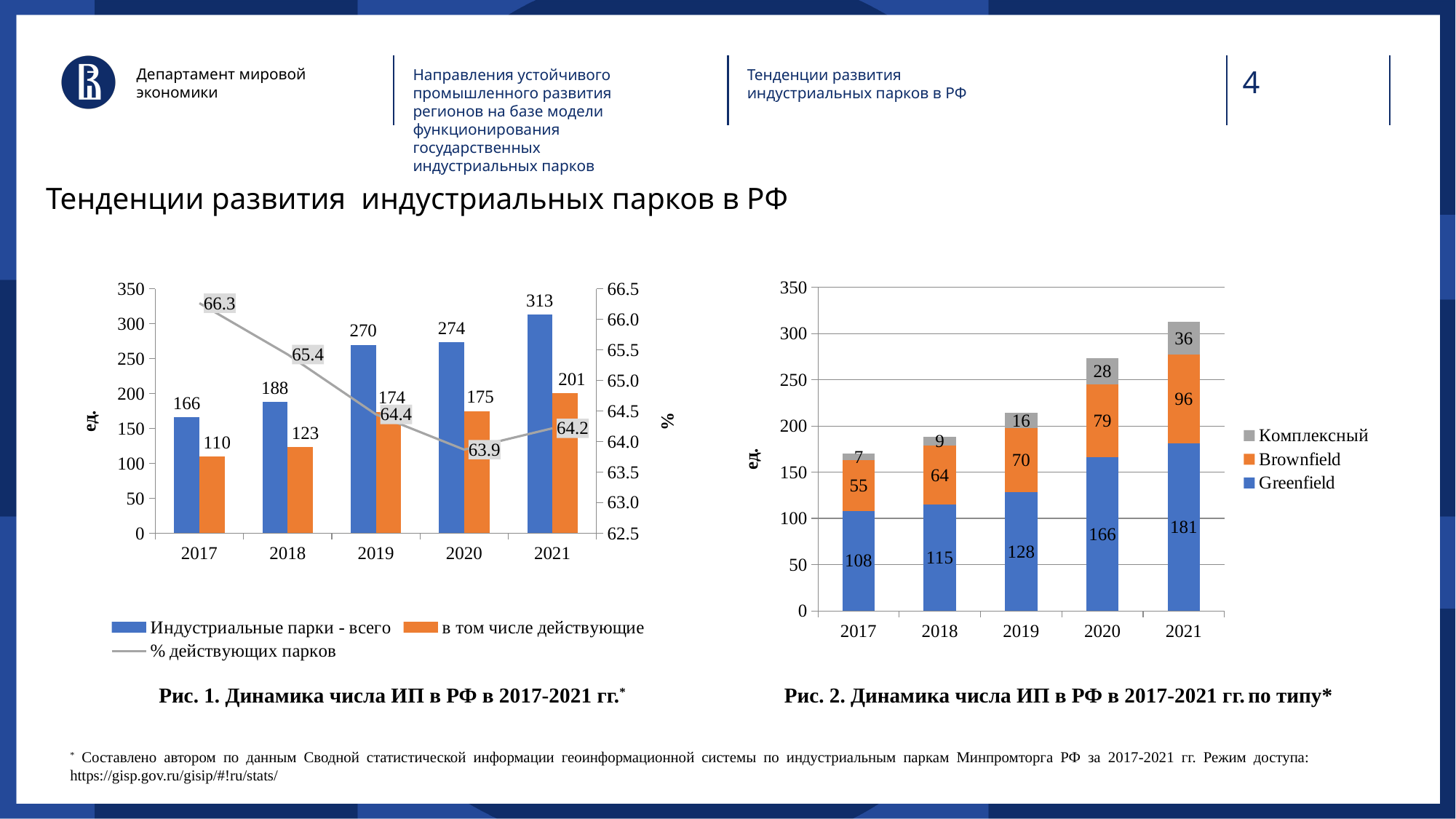
In the left chart (Рис. 1), what is the difference between 'Индустриальные парки - всего' and 'в том числе действующие' in 2017? 56 In the right chart (Рис. 2), what is the Brownfield value for 2020? 79 In the left chart (Рис. 1), what is the '% действующих парков' value for 2020? 63.9 In the left chart (Рис. 1), how many series does the legend list? 3 In the left chart (Рис. 1), what is the value of 'Индустриальные парки - всего' for 2021? 313 In the left chart (Рис. 1), in which year is the '% действующих парков' line lowest? 2020 In the right chart (Рис. 2), what is the Greenfield value for 2019? 128 In the left chart (Рис. 1), what is the value of 'в том числе действующие' for 2019? 174 In the left chart (Рис. 1), does the '% действующих парков' line rise or fall from 2017 to 2020? fall In the right chart (Рис. 2), what is the total of the stacked bar for 2021? 313 In the right chart (Рис. 2), which is larger: the Комплексный value for 2021 or the Комплексный value for 2018? 2021 What kind of chart is the right chart (Рис. 2)? stacked bar chart